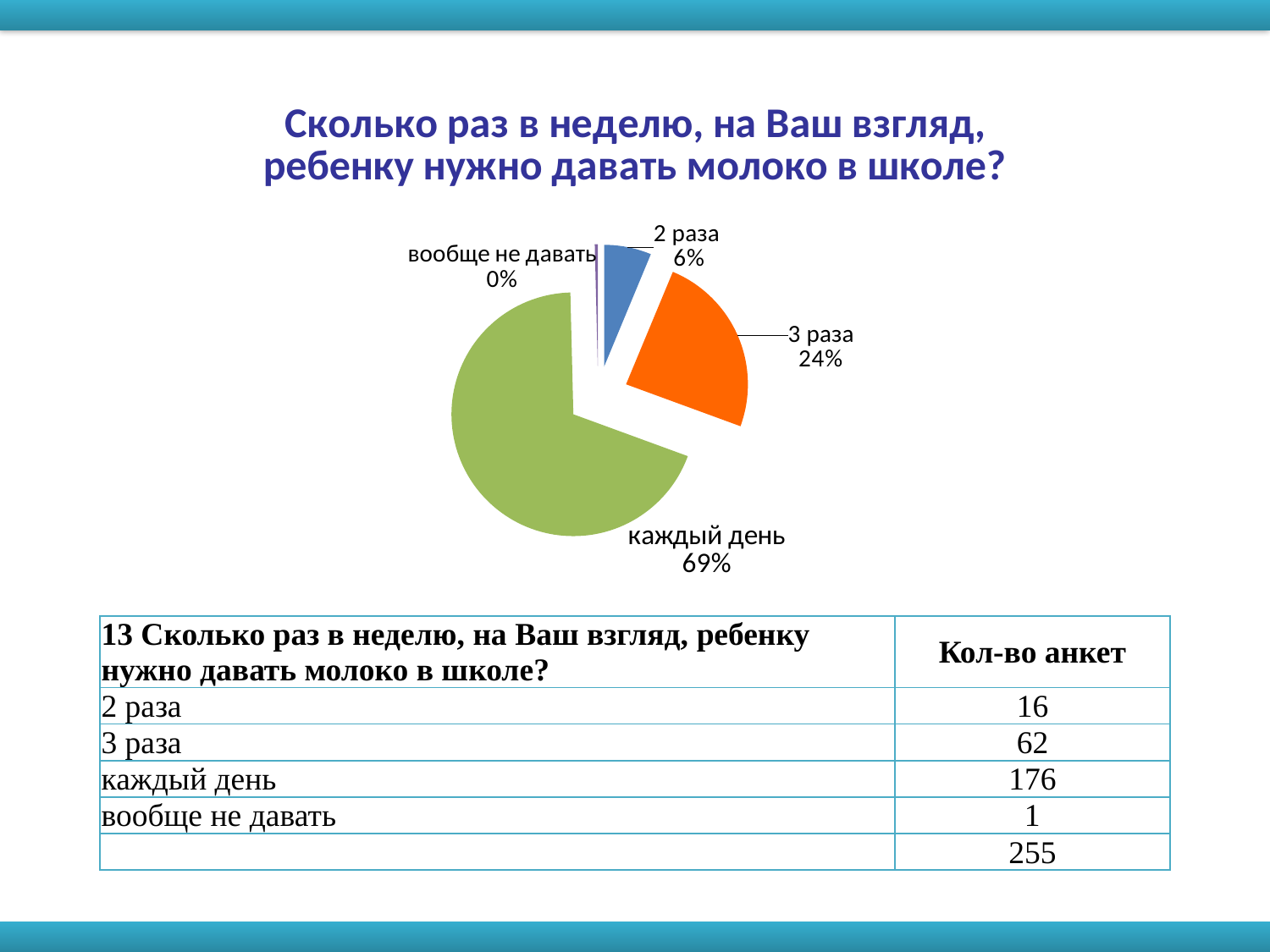
What percentage is shown for the slice "каждый день"? 69% What is the difference in percentage points between the "каждый день" slice and the "3 раза" slice? 45 What percentage is shown for the slice "вообще не давать"? 0% What percentage is shown for the slice "2 раза"? 6% What kind of chart is shown on the slide? pie chart Which slice of the pie chart is the smallest? вообще не давать What percentage is shown for the slice "3 раза"? 24% Which slice of the pie chart is the largest? каждый день How many slices (categories) does the pie chart have? 4 What is the title of the chart on the slide? Сколько раз в неделю, на Ваш взгляд, ребенку нужно давать молоко в школе? Which slice is larger, "3 раза" or "2 раза"? 3 раза What colour is the "каждый день" slice? green